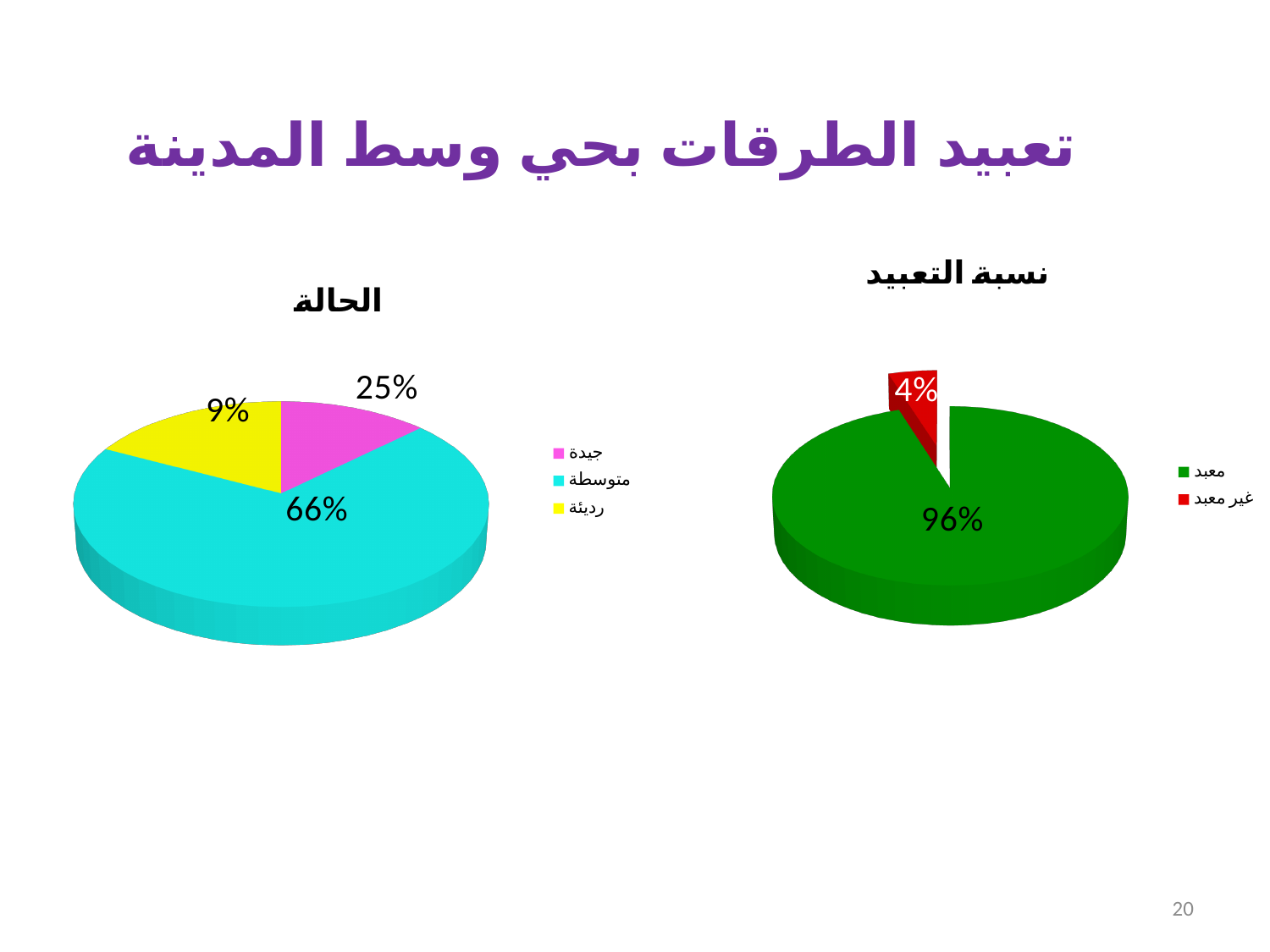
In the pie chart titled "نسبة التعبيد" on the right, what is the difference in percentage points between "معبد" and "غير معبد"? 92 In the pie chart titled "الحالة" on the left, which category has the smallest share? رديئة In the pie chart titled "الحالة" on the left, what percentage is shown for "جيدة"? 25% In the pie chart titled "الحالة" on the left, what is the difference in percentage points between "متوسطة" and "جيدة"? 41 What type of chart is the chart titled "نسبة التعبيد" on the right? Pie chart In the pie chart titled "الحالة" on the left, which category has the largest share? متوسطة In the pie chart titled "نسبة التعبيد" on the right, what percentage is shown for "غير معبد"? 4% In the pie chart titled "نسبة التعبيد" on the right, what percentage is shown for "معبد"? 96% In the pie chart titled "الحالة" on the left, what percentage is shown for "متوسطة"? 66% In the pie chart titled "الحالة" on the left, what percentage is shown for "رديئة"? 9% How many slices does the pie chart titled "الحالة" on the left have? 3 In the pie chart titled "الحالة" on the left, which is larger: "جيدة" or "رديئة"? جيدة